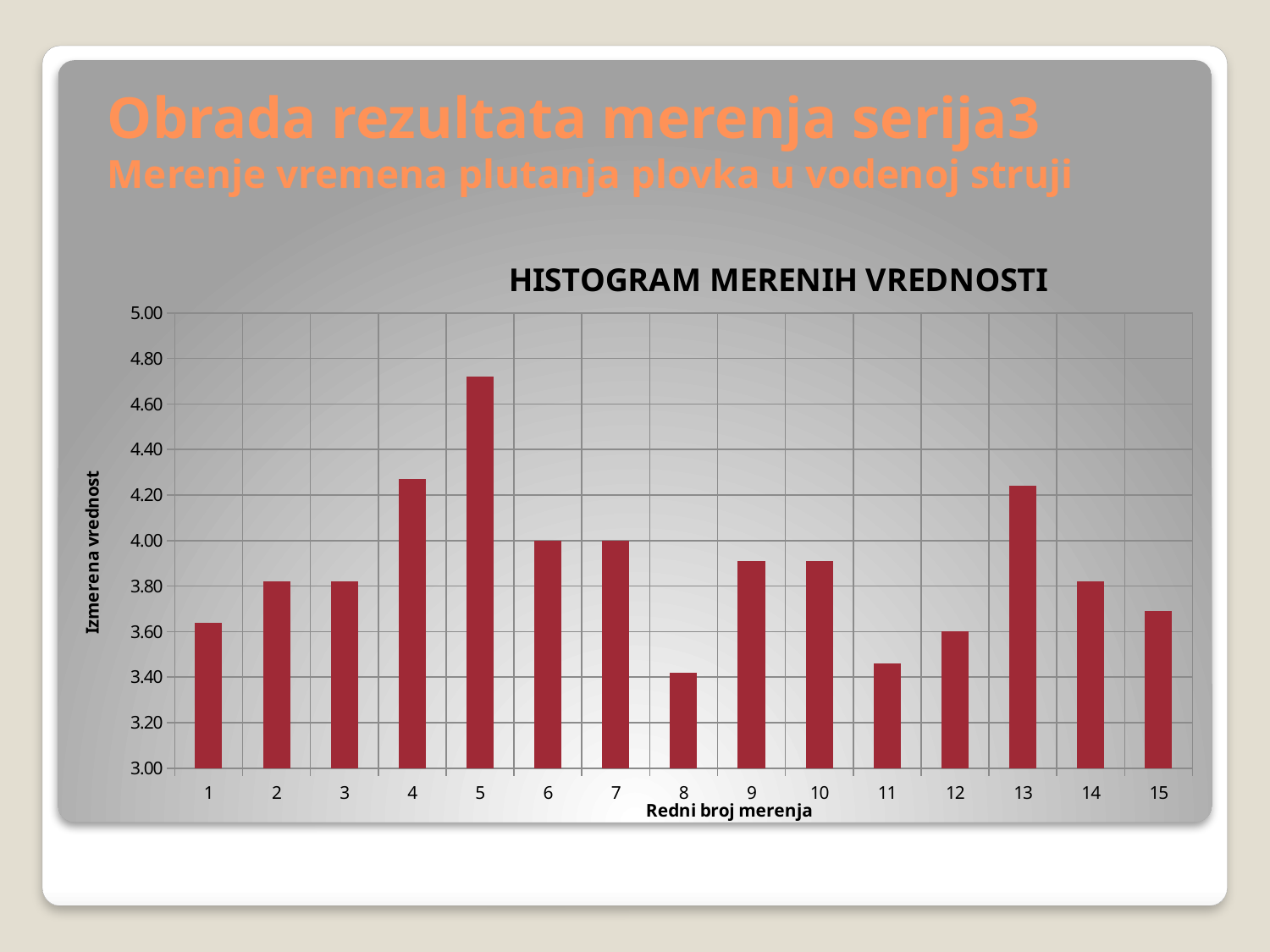
Which measurement number has the highest value? 5 Is the value for measurement 5 greater or less than 4.60? greater Which has a larger value, measurement 2 or measurement 1? measurement 2 What type of chart is shown on the slide? bar chart What is the value for measurement 6? 4.00 What is the label of the x axis? Redni broj merenja Which has a larger value, measurement 5 or measurement 4? measurement 5 Is the value for measurement 9 greater or less than 3.80? greater What is the title of the chart? HISTOGRAM MERENIH VREDNOSTI Is the value for measurement 8 greater or less than 3.60? less How many measurements (bars) are plotted on the chart? 15